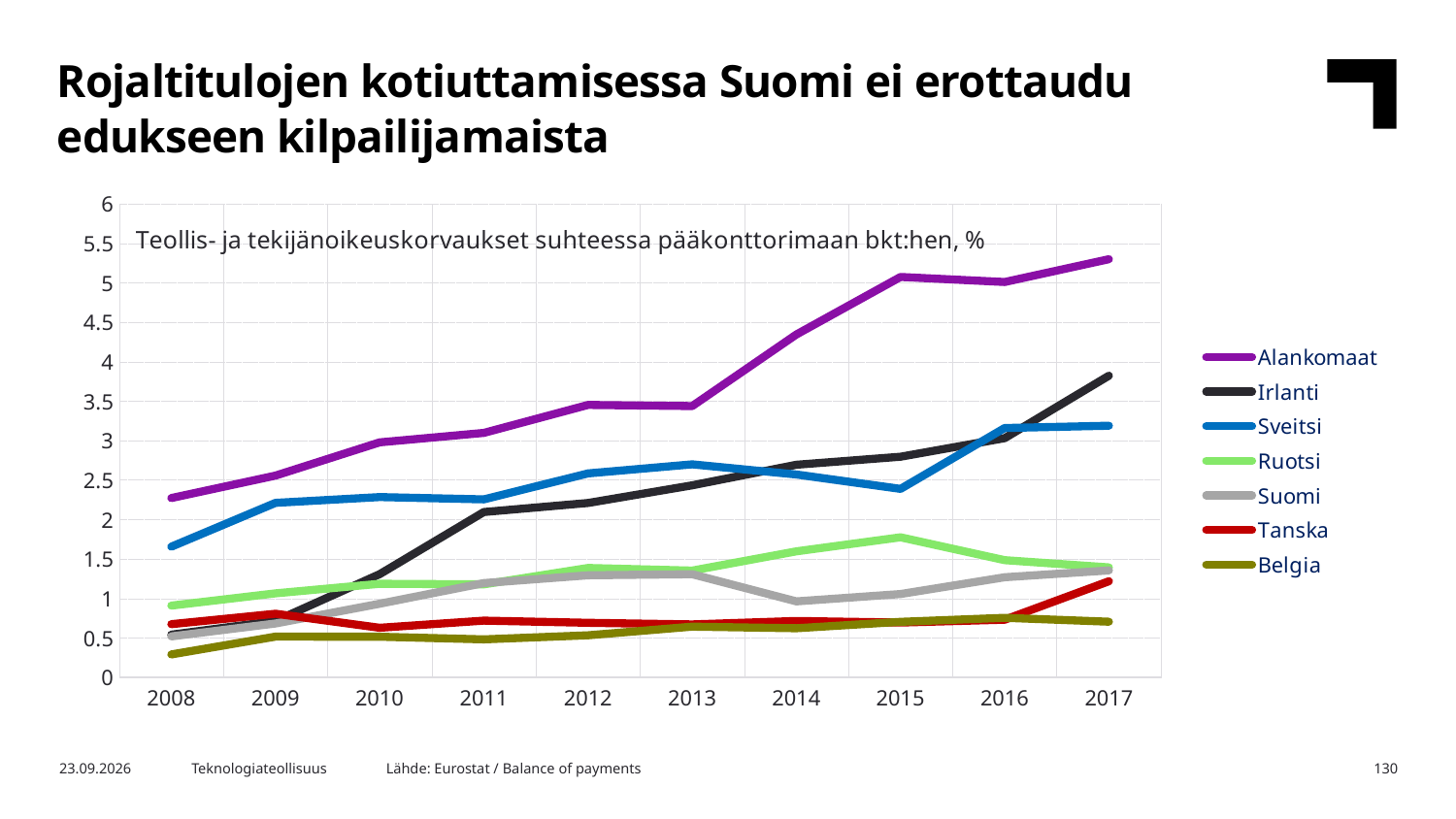
Is the value for Belgia in 2008 greater or less than 0.5? less Which country has the highest value in 2017? Alankomaat In 2015, which is larger: the value for Irlanti or the value for Sveitsi? Irlanti How many years are shown on the x axis? 10 What type of chart is shown on the slide? line chart Which country has the lowest value in 2008? Belgia Does the value for Alankomaat rise or fall from 2008 to 2017? rise Is the value for Alankomaat in 2017 greater or less than 5? greater How many series does the legend list? 7 What is the title text shown inside the chart area? Teollis- ja tekijänoikeuskorvaukset suhteessa pääkonttorimaan bkt:hen, % In 2015, which is larger: the value for Ruotsi or the value for Suomi? Ruotsi Is the value for Irlanti in 2017 greater or less than 3.5? greater